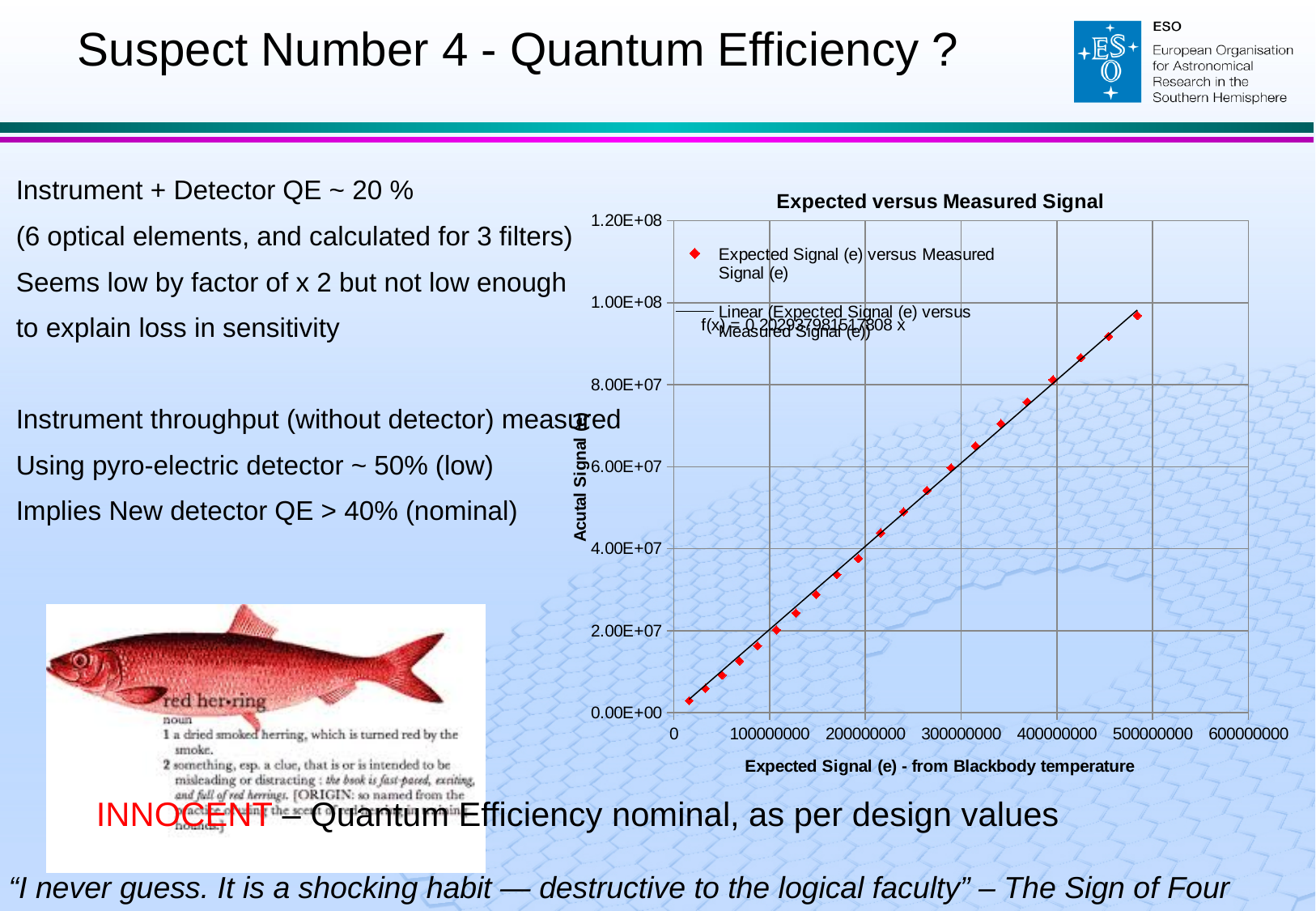
What is the highest tick value shown on the y axis? 1.20E+08 Is the actual signal of the point with the largest expected signal greater or less than 1.00E+08? less What is the label of the x axis of the chart? Expected Signal (e) - from Blackbody temperature What is the highest tick value shown on the x axis? 600000000 How many entries does the chart legend list? 2 Is the actual signal of the lowest plotted point greater or less than 2.00E+07? less Which plotted point has the highest actual signal: the one with the largest expected signal or the one with the smallest expected signal? the one with the largest expected signal What kind of chart is shown on the slide? scatter chart Is the actual signal of the highest plotted point greater or less than 8.00E+07? greater What is the title of the chart? Expected versus Measured Signal Do the plotted values rise or fall as the expected signal increases along the x axis? rise